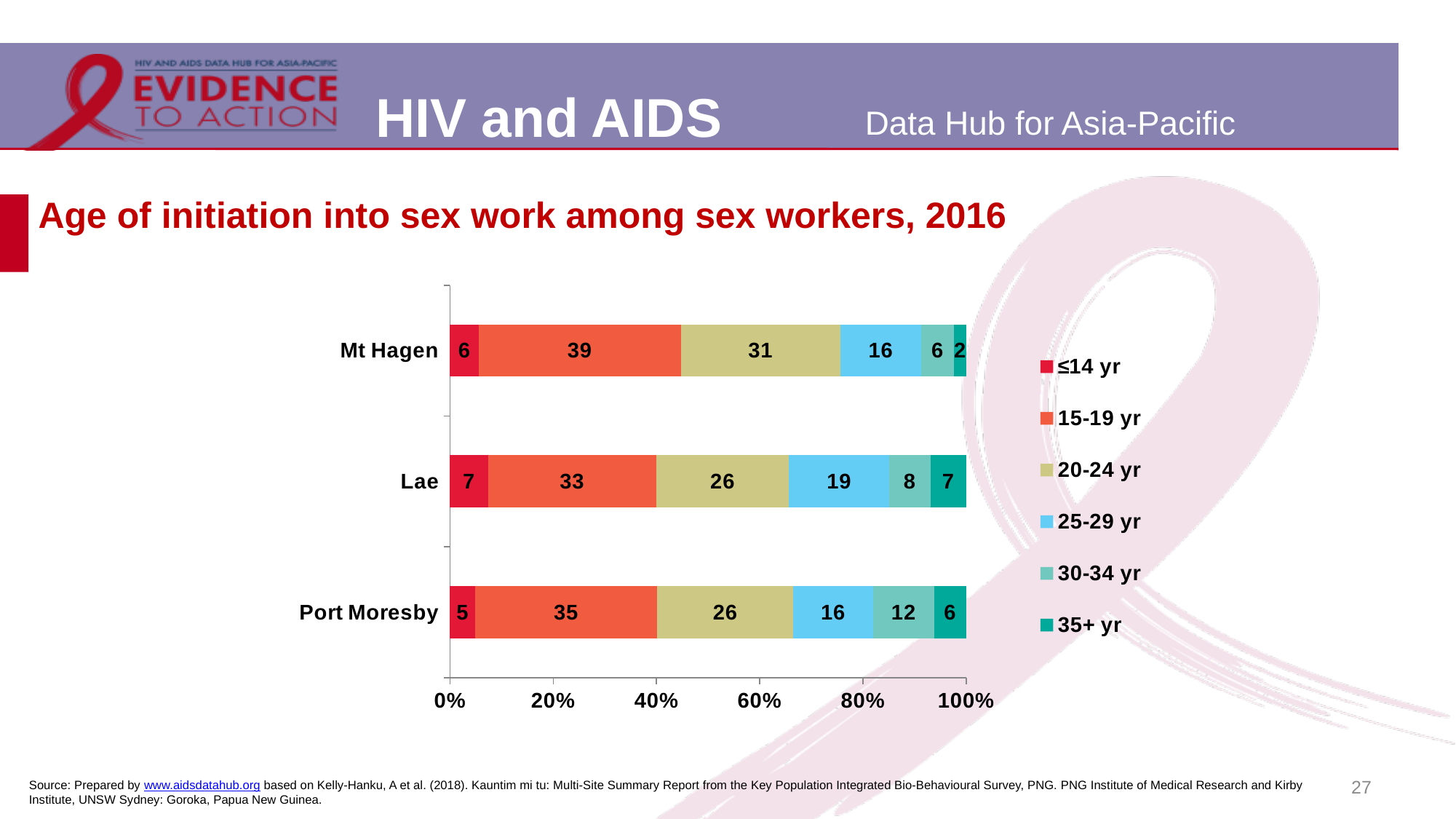
What is the value for the 15-19 yr segment of the Mt Hagen bar? 39 How many cities are shown on the chart? 3 How many age groups does the legend list? 6 What colour represents the ≤14 yr age group in the legend? Red Which is larger, the 20-24 yr value for Mt Hagen or for Lae? Mt Hagen What is the difference between the 30-34 yr values for Port Moresby and Mt Hagen? 6 Which city has the lowest value for the 35+ yr segment? Mt Hagen Which city has the highest value for the 15-19 yr segment? Mt Hagen What is the total of all segments in the Lae bar? 100 What is the value for the 25-29 yr segment of the Lae bar? 19 What kind of chart is shown on the slide? Stacked bar chart What is the value for the 30-34 yr segment of the Port Moresby bar? 12